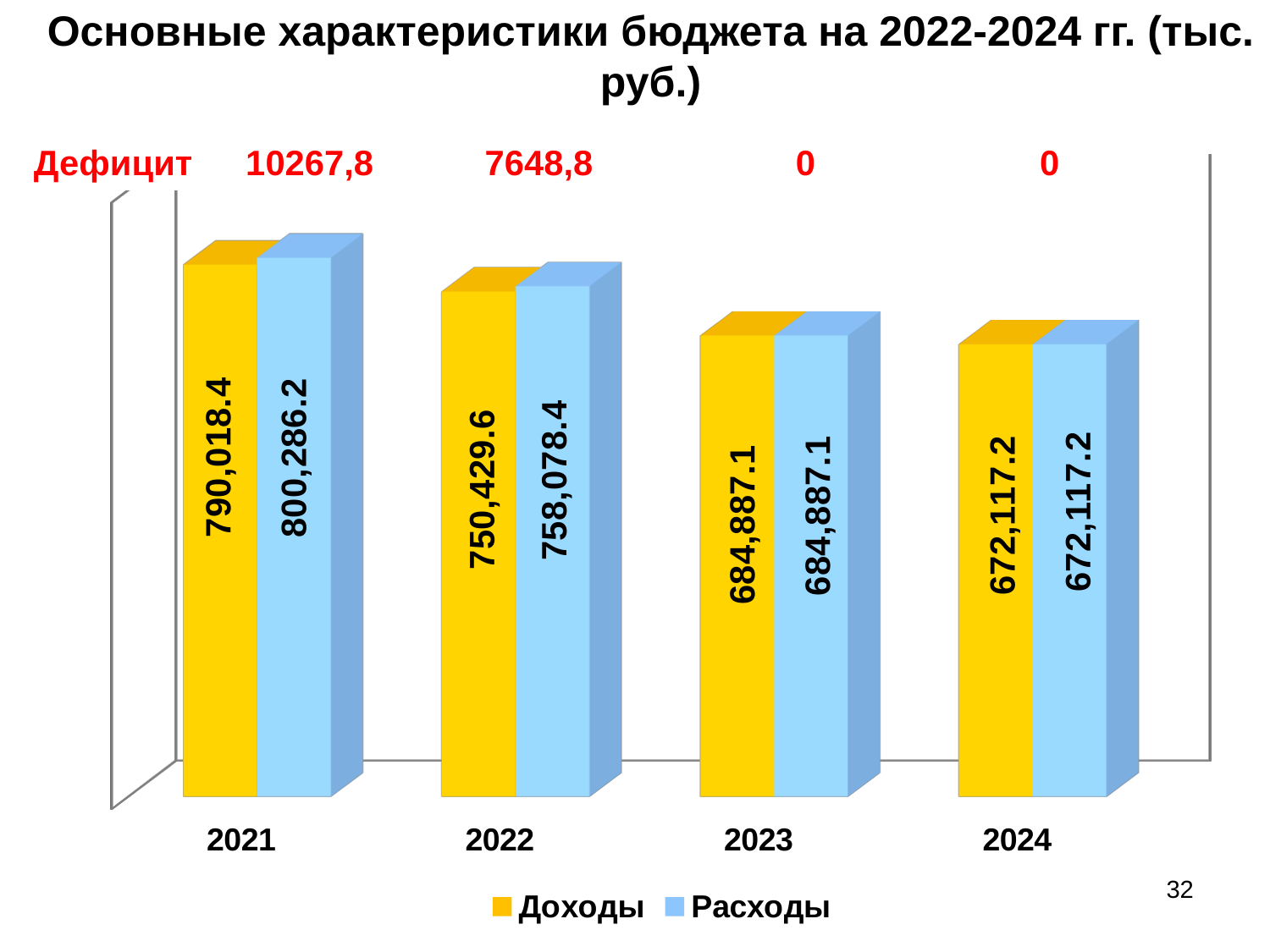
Do the Доходы values rise or fall from 2021 to 2024? Fall Which year has the lowest value for Доходы? 2024 How many series does the legend list? 2 Which year has the highest value for Расходы? 2021 What is the value of Расходы for 2022? 758,078.4 What is the value of Доходы for 2021? 790,018.4 Which is larger in 2022, Доходы or Расходы? Расходы What is the value of Доходы for 2023? 684,887.1 What is the difference between Расходы and Доходы in 2021? 10,267.8 How many years are shown on the x axis? 4 What is the value of Расходы for 2024? 672,117.2 What kind of chart is shown on the slide? Bar chart